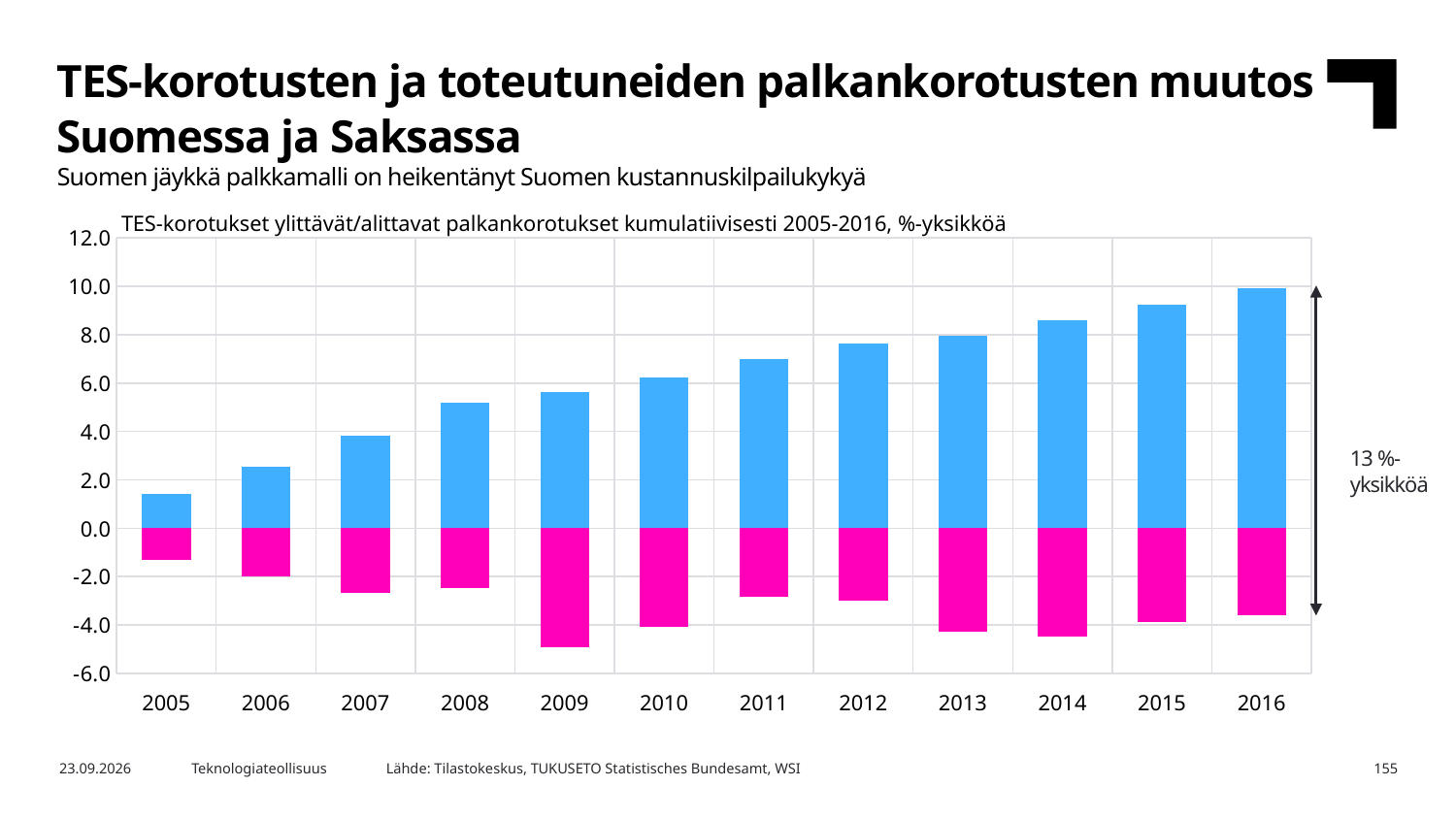
Which year has the tallest blue (positive) bar? 2016 Is the value of the blue bar for 2005 greater or less than 2.0? less Is the value of the magenta bar for 2009 greater or less than -4.0? less Which year has the shortest blue (positive) bar? 2005 What is the title printed above the chart? TES-korotukset ylittävät/alittavat palkankorotukset kumulatiivisesti 2005-2016, %-yksikköä How many years are shown on the x axis of the chart? 12 Which blue bar is taller, 2008 or 2012? 2012 Which year has the longest magenta (negative) bar? 2009 Is the value of the blue bar for 2016 greater or less than 8.0? greater Do the blue bars rise or fall from 2005 to 2016? rise What kind of chart is shown on the slide? bar chart What does the annotation next to the arrow on the right of the chart say? 13 %-yksikköä